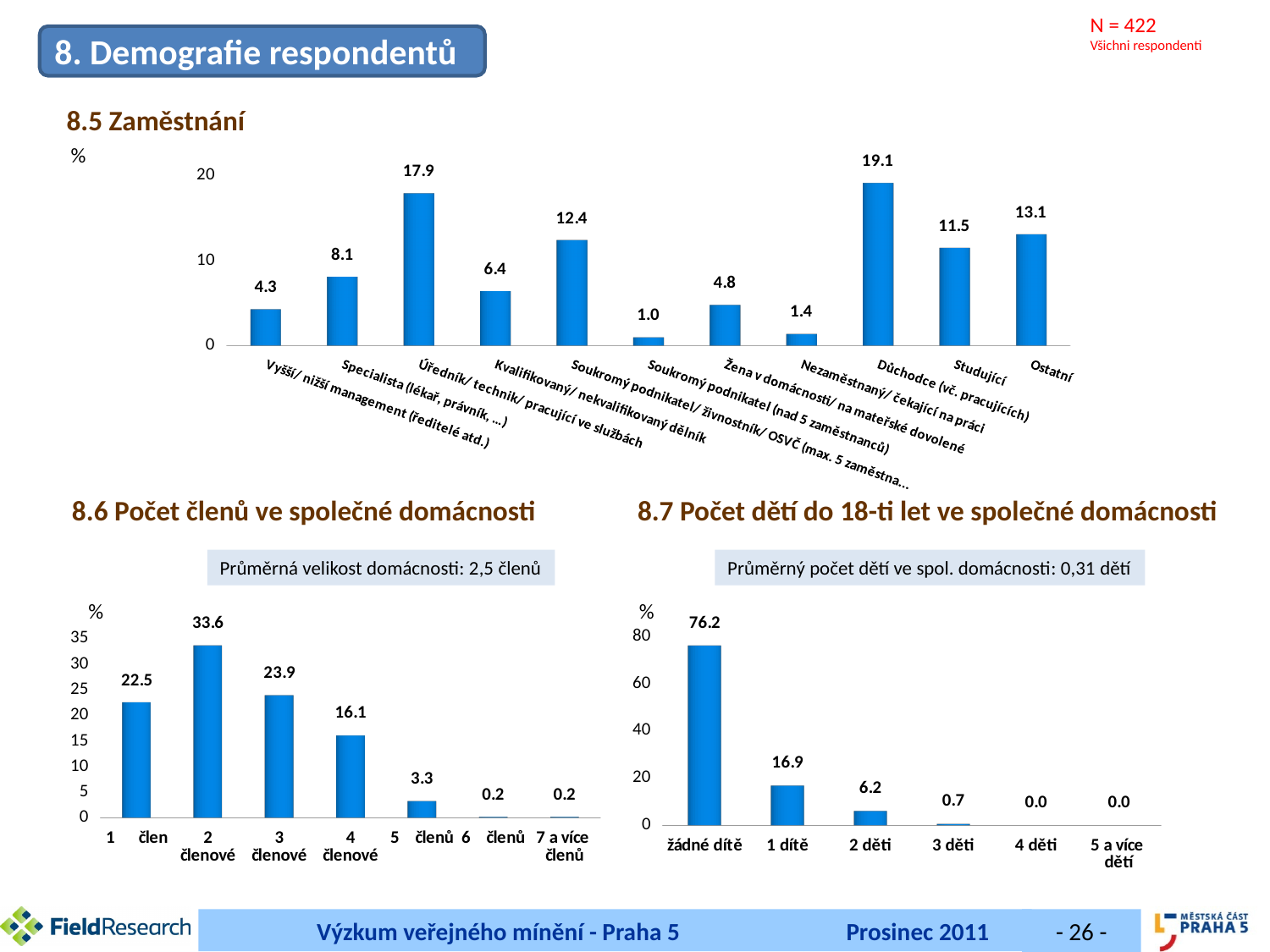
How many categories are shown in the chart '8.7 Počet dětí do 18-ti let ve společné domácnosti'? 6 In the chart '8.5 Zaměstnání', what is the value for Důchodce (vč. pracujících)? 19.1 In the chart '8.5 Zaměstnání', what is the difference between the values for Studující and Specialista (lékař, právník, ...)? 3.4 In the chart '8.7 Počet dětí do 18-ti let ve společné domácnosti', do the values rise or fall from left to right along the x axis? fall In the chart '8.5 Zaměstnání', which is larger: the value for Ostatní or the value for Studující? Ostatní What type of chart is '8.6 Počet členů ve společné domácnosti'? bar chart In the chart '8.5 Zaměstnání', which category has the lowest value? Soukromý podnikatel (nad 5 zaměstnanců) In the chart '8.6 Počet členů ve společné domácnosti', what is the value for 2 členové? 33.6 In the chart '8.7 Počet dětí do 18-ti let ve společné domácnosti', what is the value for 1 dítě? 16.9 How many categories are shown in the chart '8.5 Zaměstnání'? 11 In the chart '8.6 Počet členů ve společné domácnosti', what is the difference between the values for 3 členové and 1 člen? 1.4 In the chart '8.6 Počet členů ve společné domácnosti', which category has the highest value? 2 členové